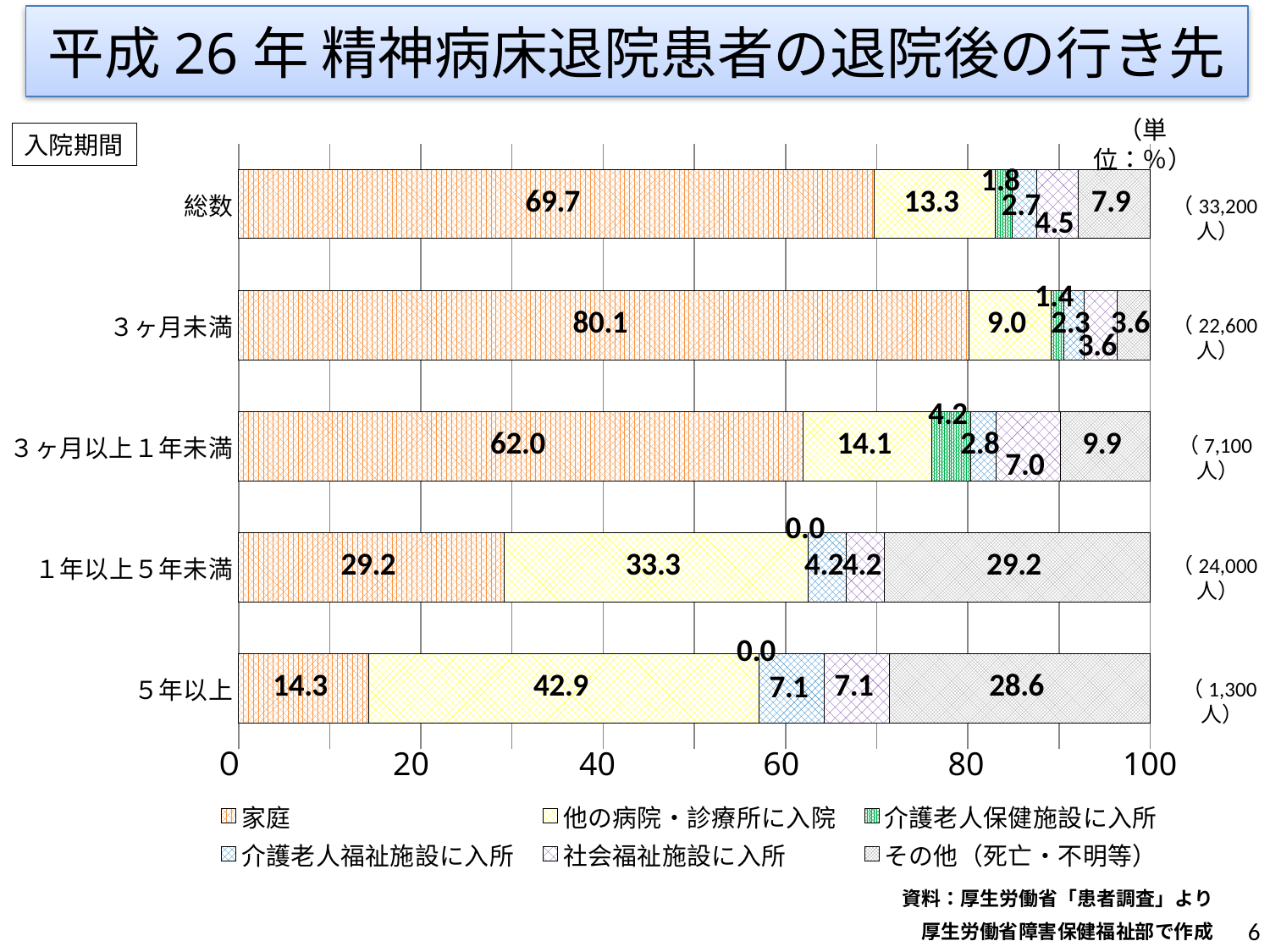
How many hospitalization period categories (bars) are shown in the chart? 5 What is the difference between the 家庭 value for 総数 and the 家庭 value for 3ヶ月以上1年未満? 7.7 Which hospitalization period category has the lowest value for 家庭? 5年以上 How many people does the 総数 bar represent, as shown to the right of the bar? 33,200人 What is the value for 他の病院・診療所に入院 in the 5年以上 bar? 42.9 Which is larger: the その他（死亡・不明等） value for 1年以上5年未満 or for 5年以上? 1年以上5年未満 How many series does the legend list? 6 Going from 3ヶ月未満 down to 5年以上, does the 家庭 value rise or fall? Fall What is the value for その他（死亡・不明等） in the 3ヶ月以上1年未満 bar? 9.9 What is the value for 家庭 in the 総数 bar? 69.7 What kind of chart is shown on the slide? Stacked bar chart Which hospitalization period category has the highest value for 家庭? 3ヶ月未満